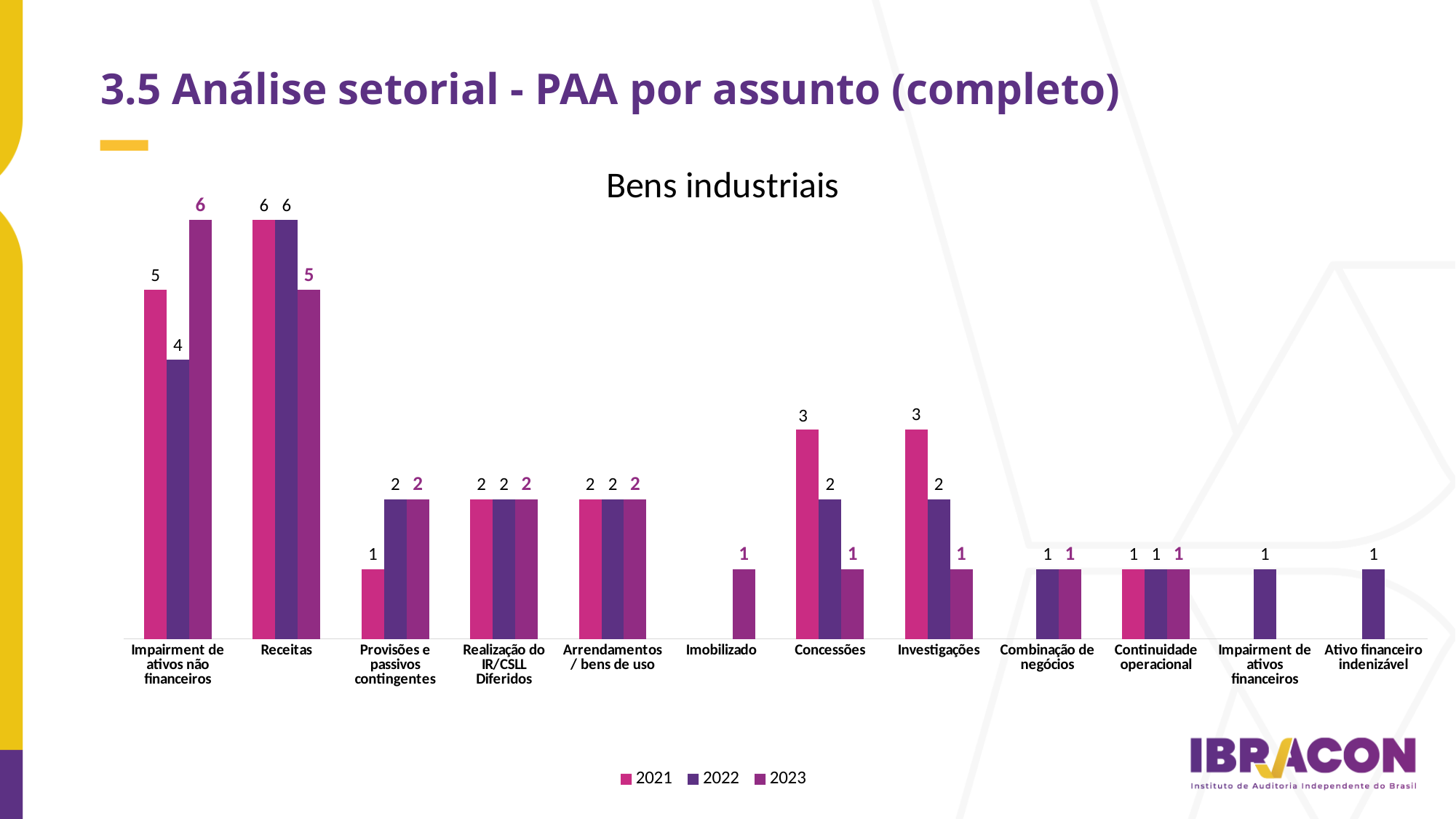
What is the 2023 value for Receitas? 5 How many series does the legend list? 3 Which category has the highest 2021 value? Receitas How many categories are shown on the x axis? 12 What is the 2023 value for Impairment de ativos não financeiros? 6 What is the 2021 value for Concessões? 3 What is the difference between the 2021 and 2023 values for Investigações? 2 What kind of chart is shown on the slide? Bar chart Which is larger for Impairment de ativos não financeiros: the 2021 value or the 2022 value? 2021 What is the 2021 value for Provisões e passivos contingentes? 1 What is the 2022 value for Impairment de ativos não financeiros? 4 What is the title of the chart? Bens industriais